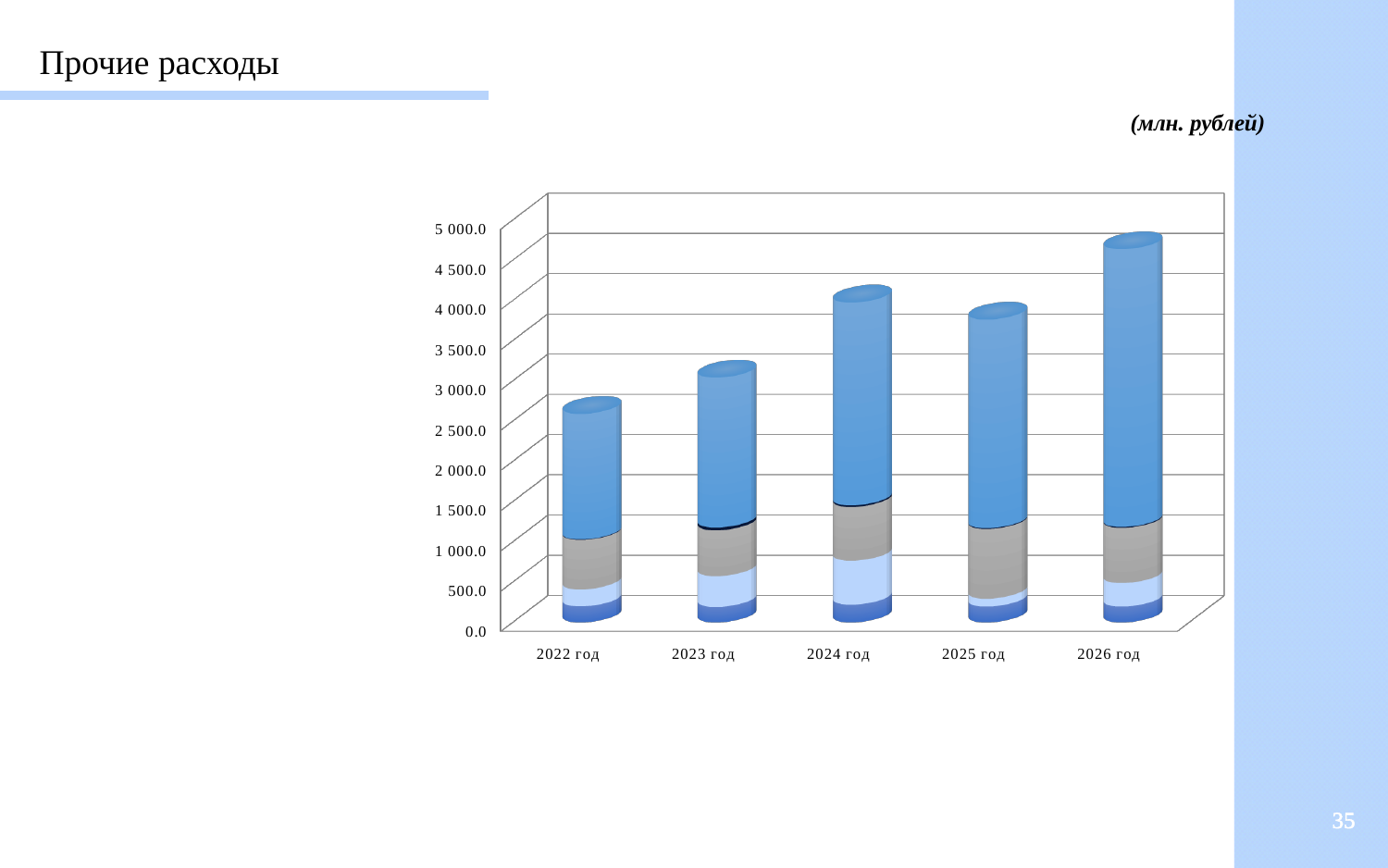
In what units are the chart values given, according to the slide? млн. рублей Is the total for 2022 год greater or less than 2 000.0? greater What is the title of the slide containing the chart? Прочие расходы Which year has the tallest stacked bar in the chart? 2026 год Is the total for 2024 год greater or less than 3 500.0? greater Is the total for 2023 год greater or less than 3 500.0? less Does the total rise or fall from 2024 год to 2025 год? fall What kind of chart is shown on the slide? Stacked bar chart Which bar is taller, 2024 год or 2025 год? 2024 год How many years (categories) are shown on the x axis of the chart? 5 Which year has the shortest stacked bar in the chart? 2022 год